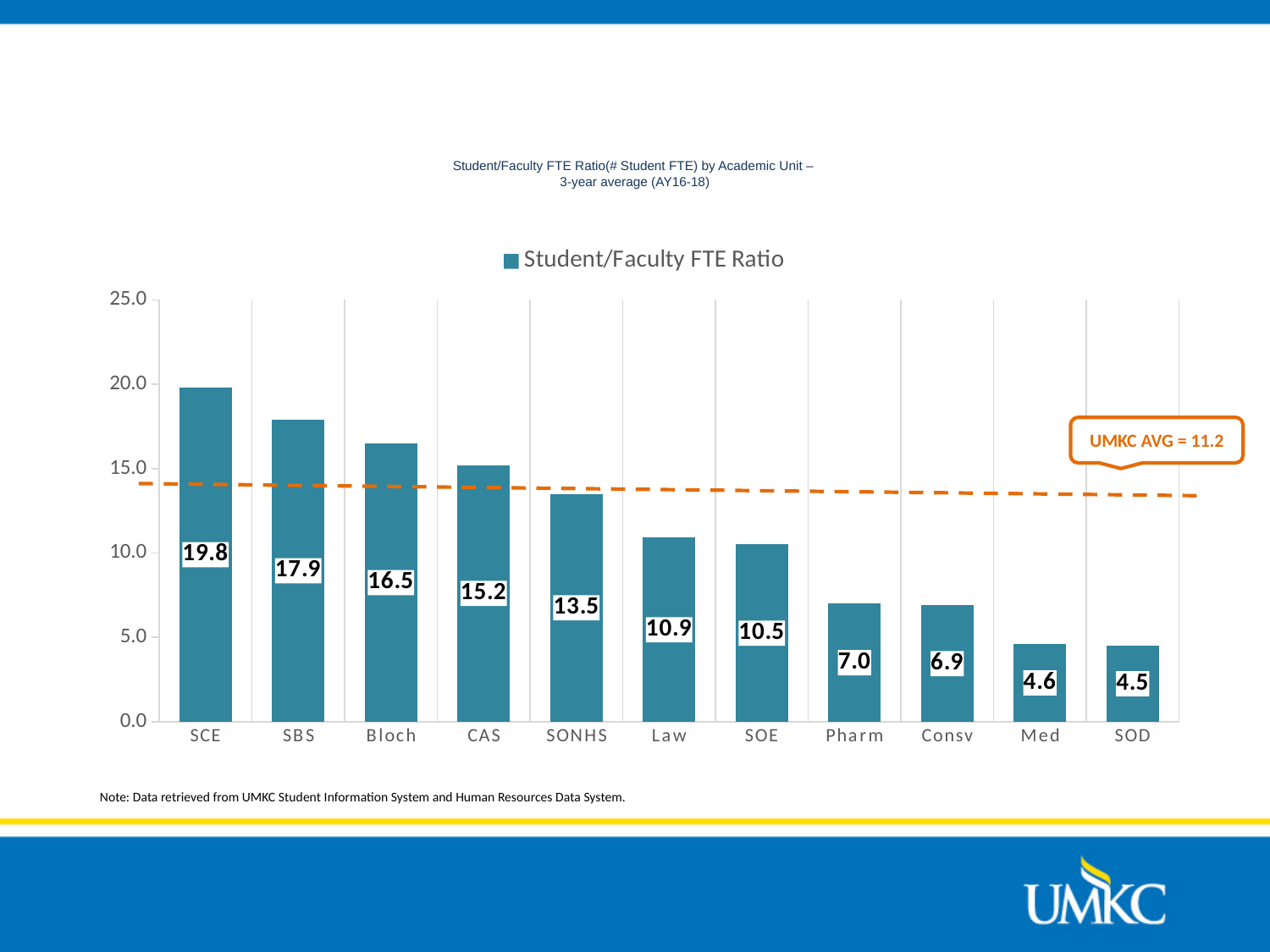
How many academic units are shown on the x axis of the chart? 11 Which has a higher Student/Faculty FTE Ratio, CAS or Pharm? CAS What is the UMKC average Student/Faculty FTE Ratio shown by the dashed line? 11.2 What is the Student/Faculty FTE Ratio for Consv? 6.9 What is the difference between the Student/Faculty FTE Ratio for SBS and for Bloch? 1.4 What kind of chart is shown on the slide? bar chart What is the Student/Faculty FTE Ratio for SCE? 19.8 Which academic unit has the lowest Student/Faculty FTE Ratio? SOD Is the Student/Faculty FTE Ratio for Med greater or less than 5.0? less What is the difference between the Student/Faculty FTE Ratio for Law and for SOE? 0.4 Which academic unit has the highest Student/Faculty FTE Ratio? SCE What is the Student/Faculty FTE Ratio for SONHS? 13.5